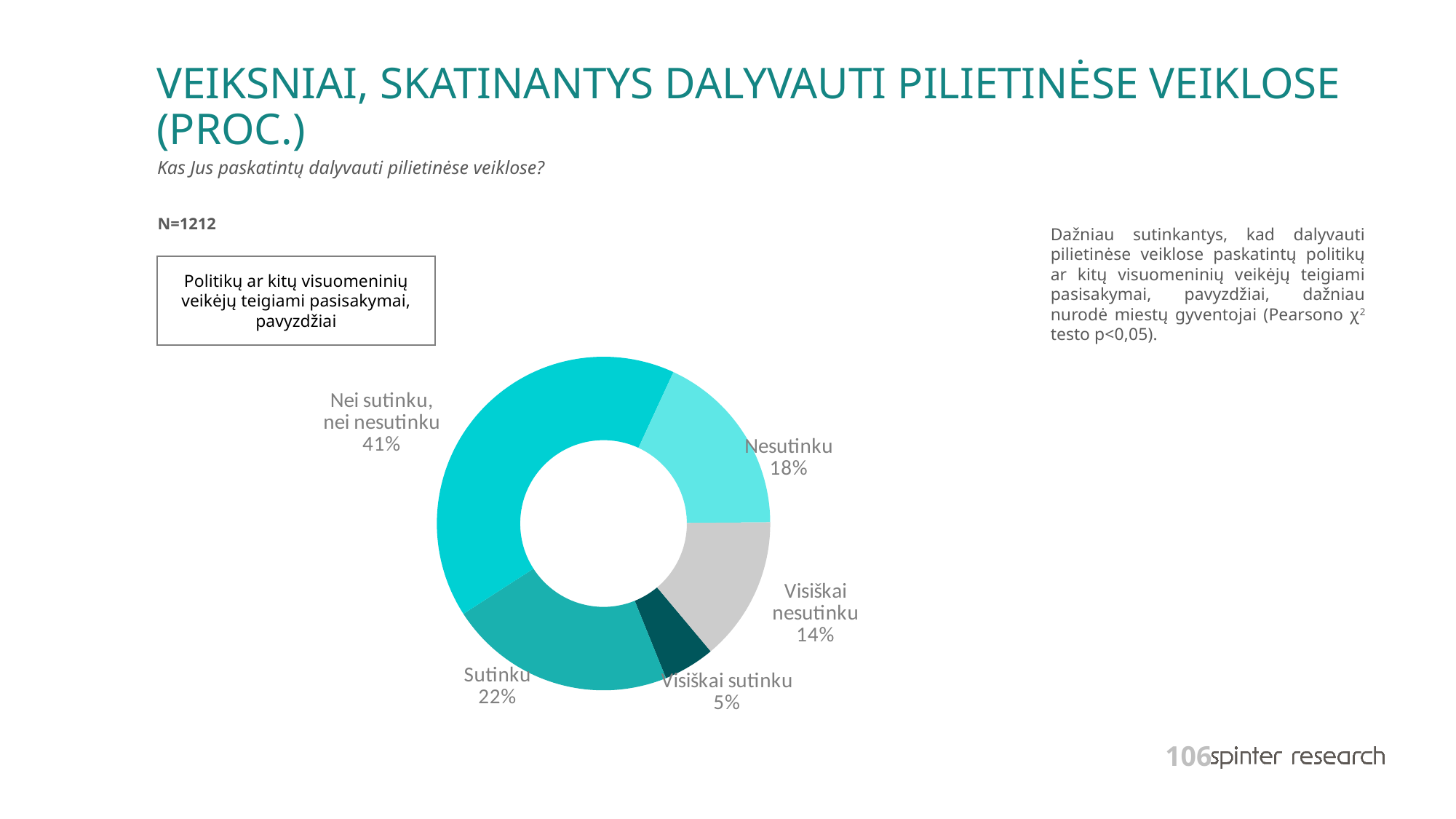
What percentage of respondents answered "Nei sutinku, nei nesutinku"? 41% Which is larger, the share for "Nesutinku" or the share for "Visiškai nesutinku"? Nesutinku What kind of chart is shown on the slide? Pie chart (doughnut) Which response category has the smallest share of the pie? Visiškai sutinku What percentage of respondents answered "Visiškai nesutinku"? 14% What percentage of respondents answered "Sutinku"? 22% What percentage of respondents answered "Visiškai sutinku"? 5% Which response category has the largest share of the pie? Nei sutinku, nei nesutinku How many response categories are shown in the chart? 5 What is the difference in percentage points between "Sutinku" and "Nesutinku"? 4 What is the combined share of "Sutinku" and "Visiškai sutinku"? 27% What is the sample size (N) stated on the slide? N=1212